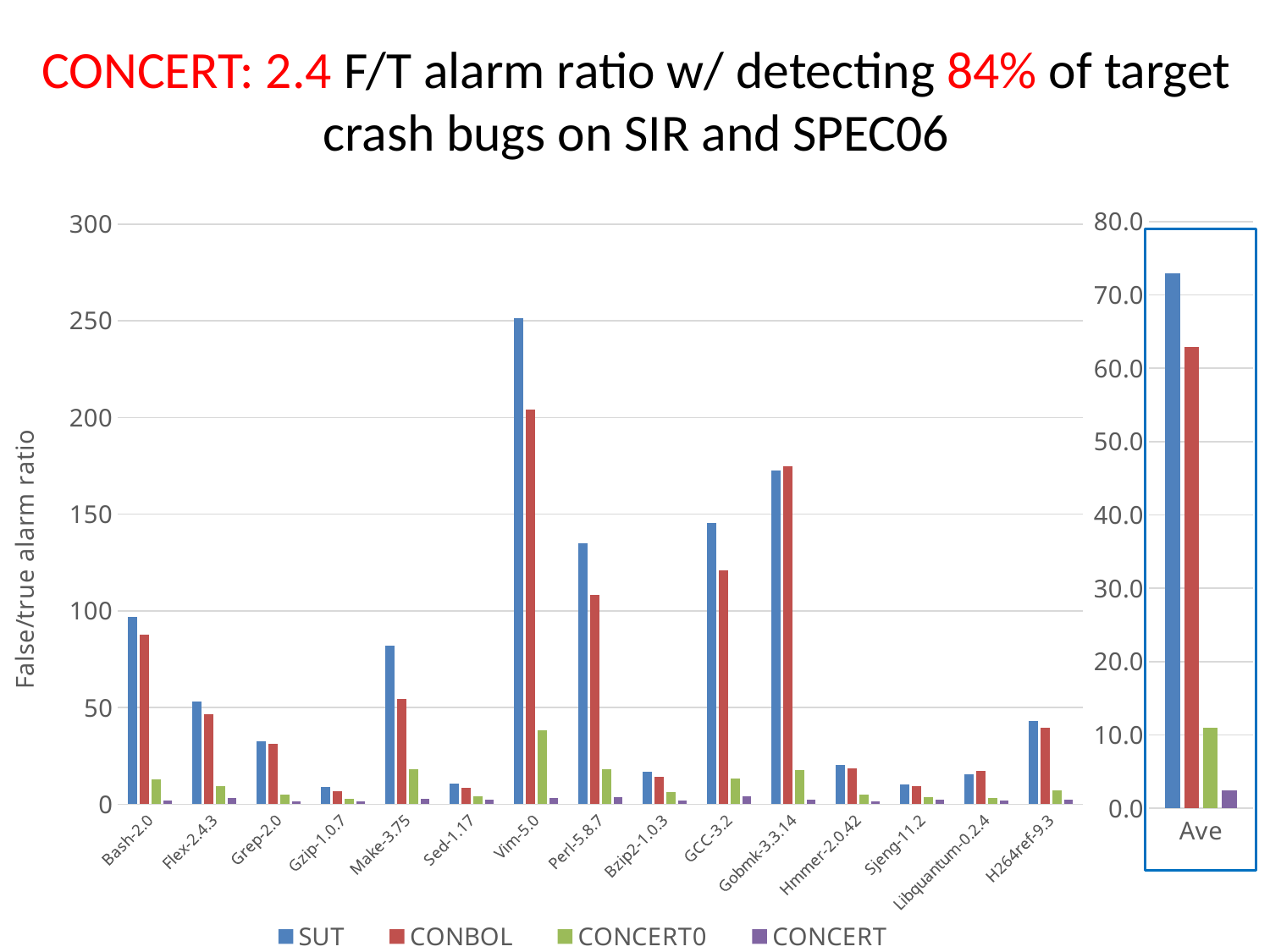
How many series does the legend of the main chart list? 4 How many program categories are shown on the x axis of the main chart? 15 In the Ave chart on the right, which series has the highest value? SUT In the main chart, which is larger for Perl-5.8.7, the SUT value or the CONBOL value? SUT In the Ave chart on the right, is the CONCERT0 value greater or less than 20.0? less In the main chart, is the CONBOL value for Gobmk-3.3.14 greater or less than 150? greater In the main chart, is the SUT value for Make-3.75 greater or less than 50? greater What kind of chart is the main chart on the left of the slide? bar chart What is the y-axis label of the main chart? False/true alarm ratio In the main chart, which category has the highest SUT value? Vim-5.0